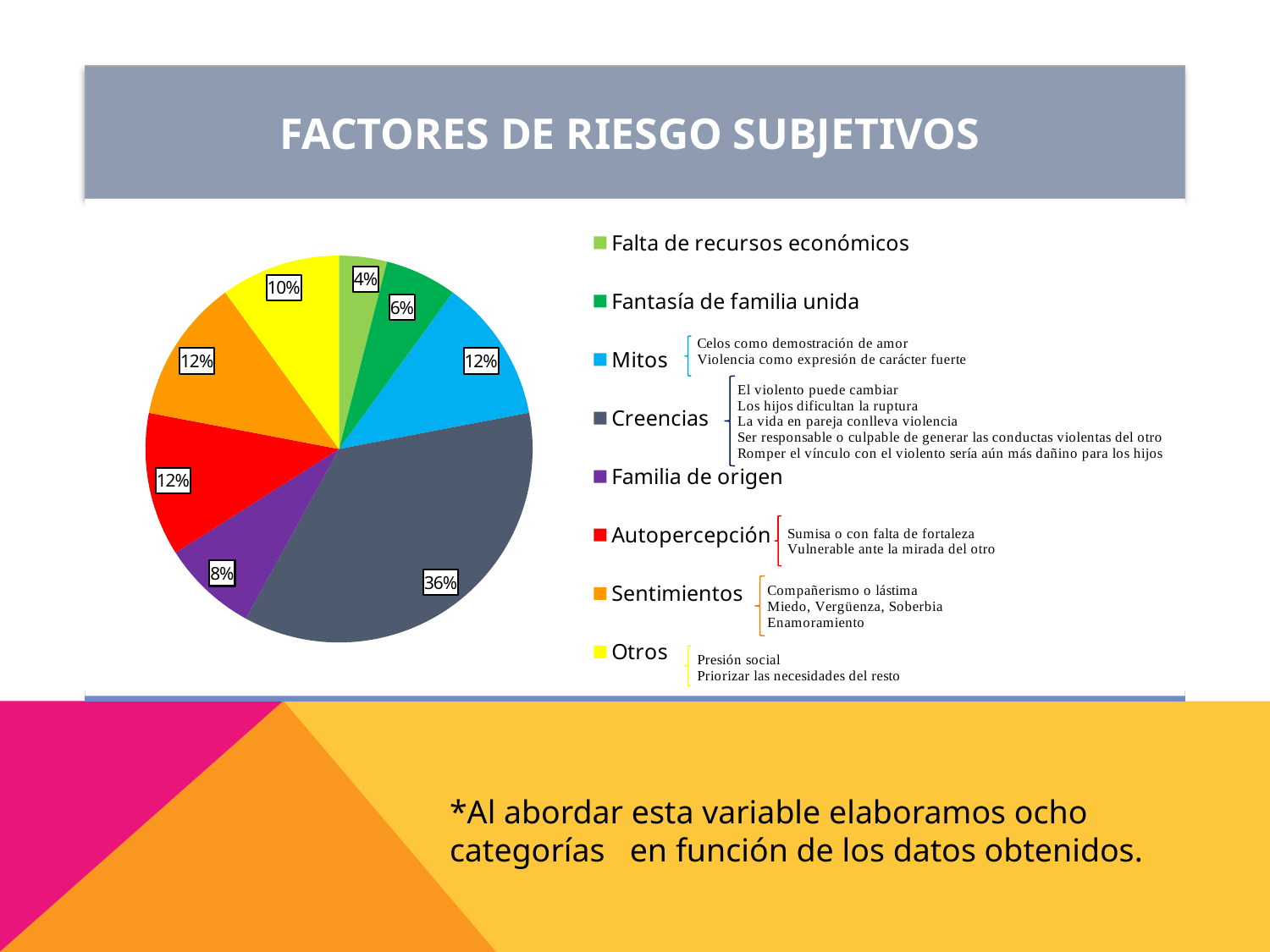
What percentage is shown for Falta de recursos económicos? 4% Which is larger, the slice for Familia de origen or the slice for Otros? Otros What percentage is shown for Familia de origen? 8% What is the difference in percentage points between Creencias and Otros? 26 How many categories does the pie chart show? 8 What type of chart is shown on the slide? Pie chart What colour is the slice for Autopercepción? Red What percentage is shown for Fantasía de familia unida? 6% Which category has the smallest slice of the pie? Falta de recursos económicos What percentage is shown for Otros? 10% Which category has the largest slice of the pie? Creencias What share of the pie does Creencias represent? 36%